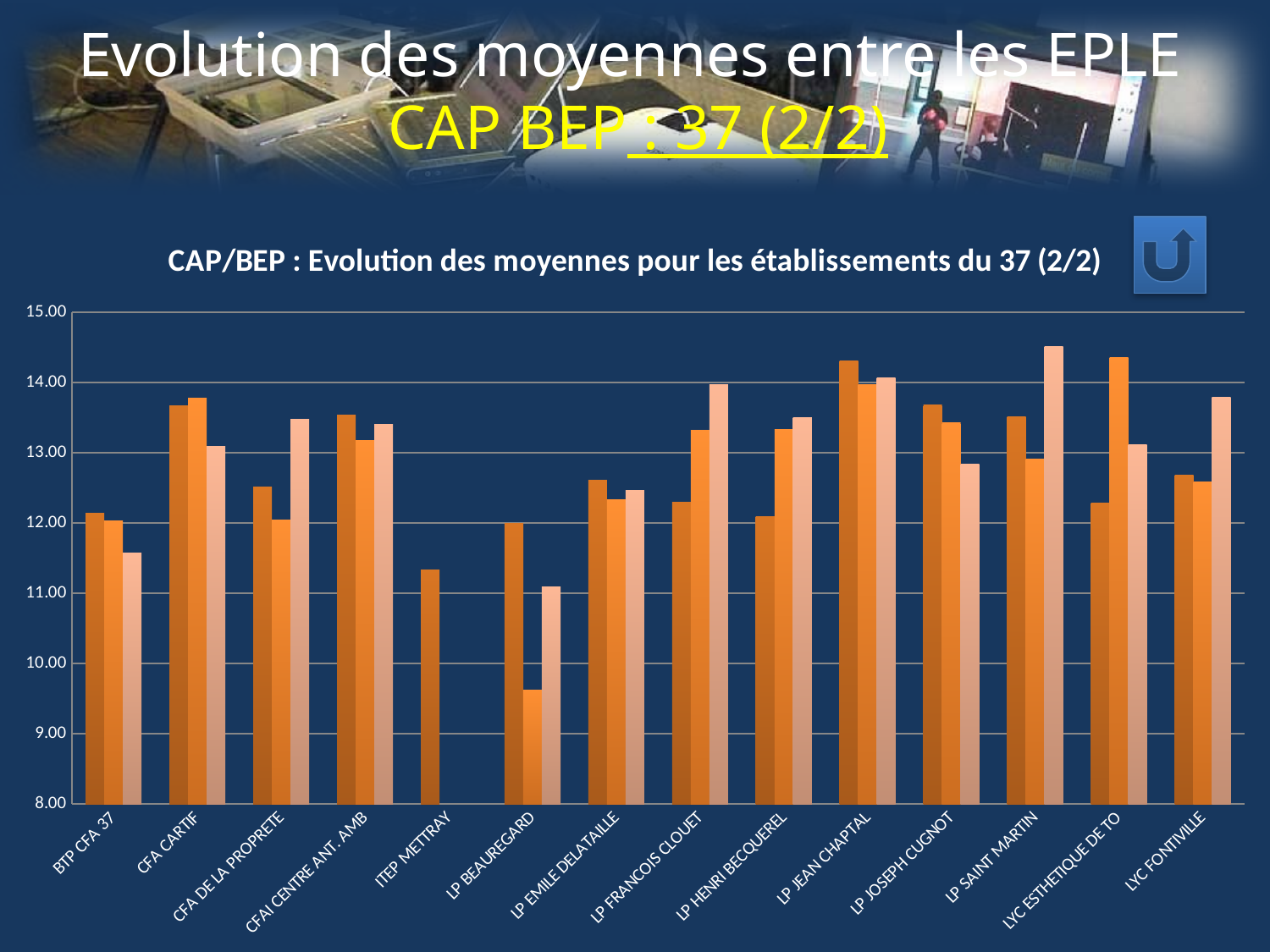
Is the value of the first (leftmost) bar for LP JEAN CHAPTAL greater or less than 14.00? greater What is the title of the chart? CAP/BEP : Evolution des moyennes pour les établissements du 37 (2/2) Which establishment has the lowest bar in the chart? LP BEAUREGARD Which is larger: the first bar for LP JEAN CHAPTAL or the first bar for LP HENRI BECQUEREL? LP JEAN CHAPTAL Is the value of the third (rightmost) bar for LP SAINT MARTIN greater or less than 14.00? greater How many establishments (categories) are shown on the x axis of the chart? 14 Is the value of the lowest bar for LP BEAUREGARD greater or less than 10.00? less How many bars are plotted for ITEP METTRAY? 1 What is the lowest value shown on the vertical axis of the chart? 8.00 What kind of chart is shown on the slide? bar chart